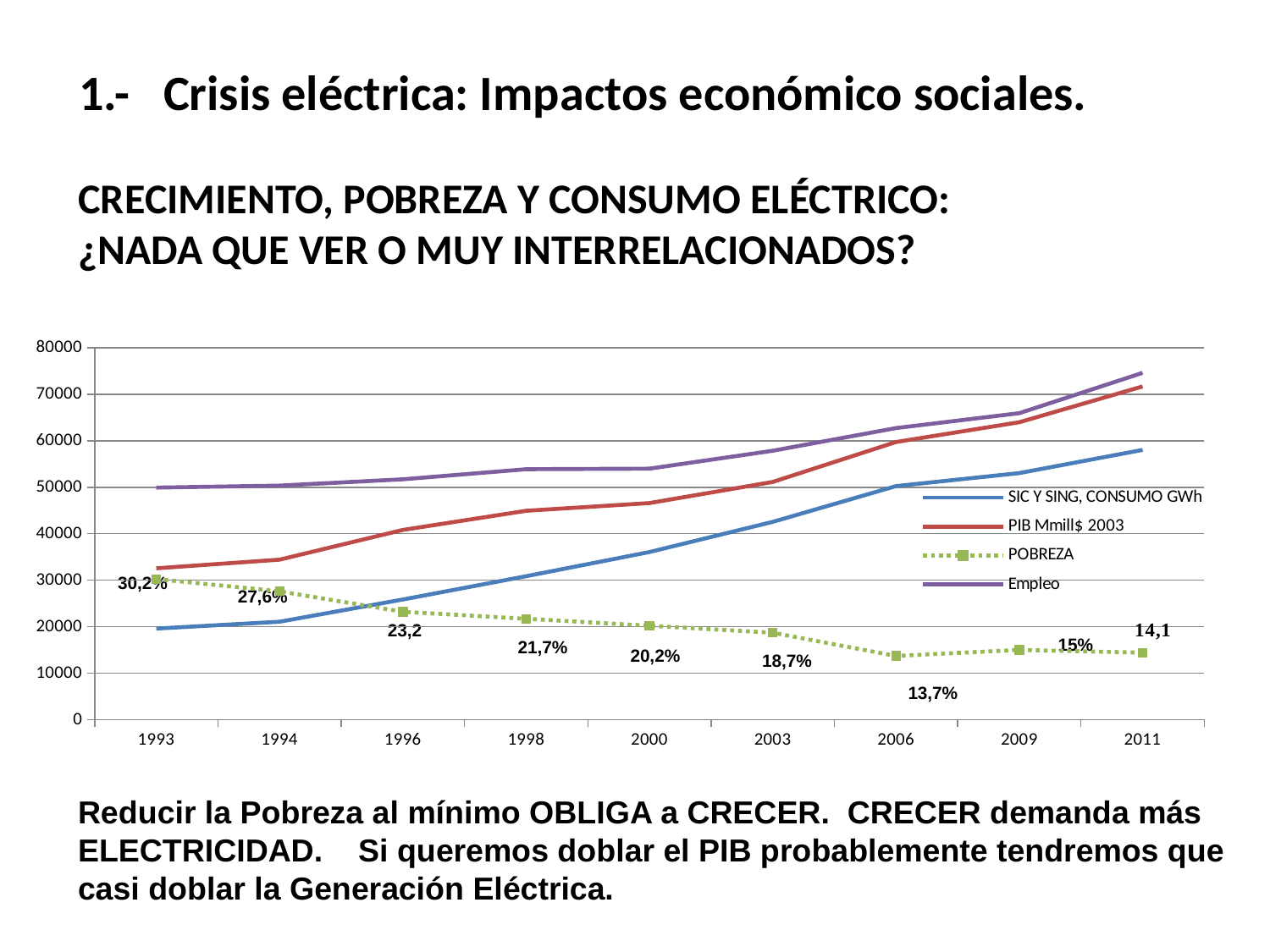
What is the POBREZA value labelled for 2006? 13,7% How many series does the chart legend list? 4 What is the POBREZA value labelled for 2011? 14,1 What is the difference between the POBREZA values for 1993 and 2006? 16,5 What is the POBREZA value labelled for 1993? 30,2% In which year is the POBREZA series at its lowest? 2006 In 2011, which is larger: Empleo or SIC Y SING, CONSUMO GWh? Empleo Does the SIC Y SING, CONSUMO GWh series rise or fall from 1993 to 2011? rise How many years are shown along the x axis of the chart? 9 Is the value for Empleo in 2011 greater or less than 70000? greater What kind of chart is shown on the slide? line chart In which year is the POBREZA series at its highest? 1993